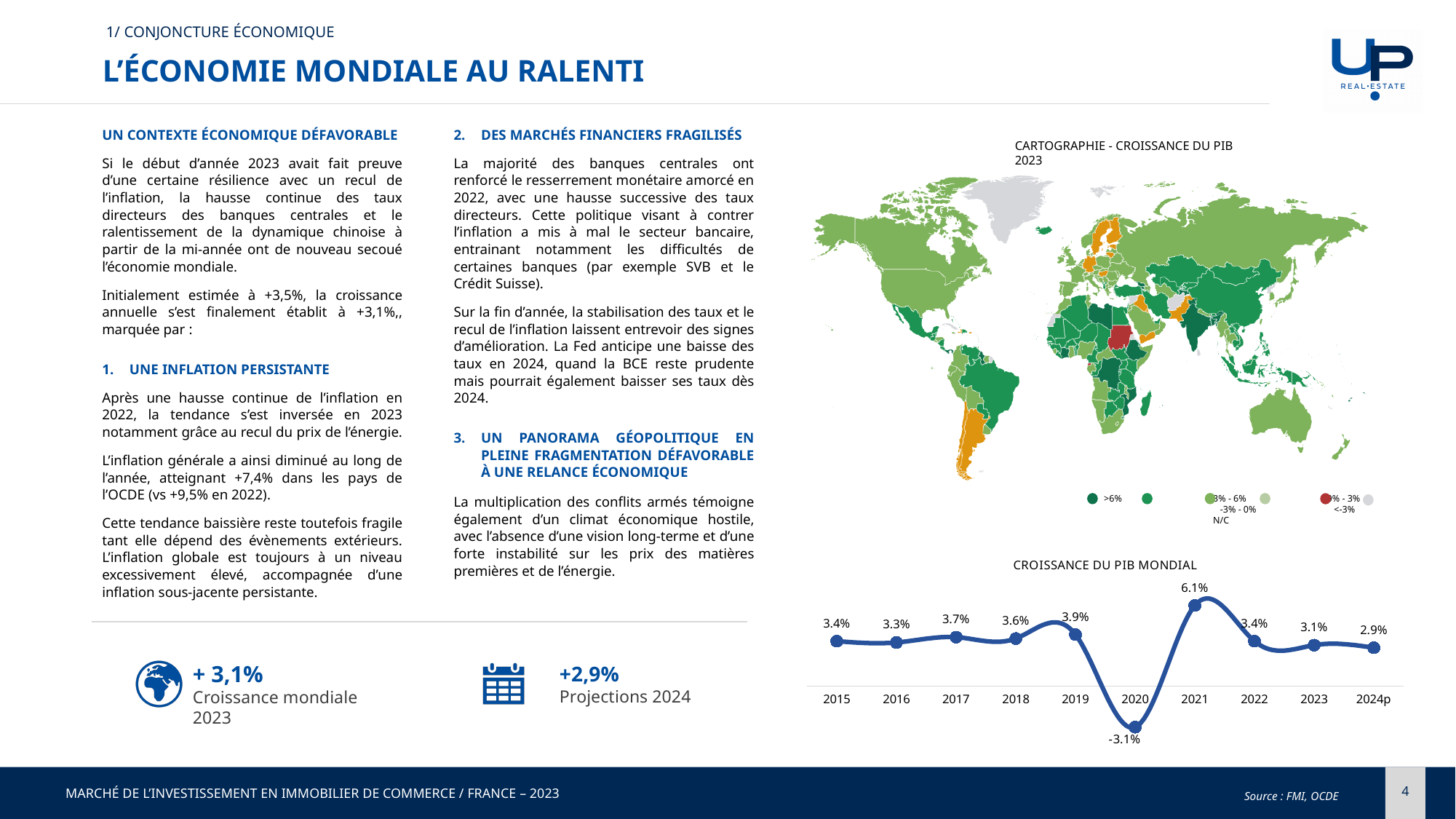
In the 'CROISSANCE DU PIB MONDIAL' chart, what is the value for 2024p? 2.9% How many years are plotted in the 'CROISSANCE DU PIB MONDIAL' chart? 10 In the 'CROISSANCE DU PIB MONDIAL' chart, which is larger, the value for 2017 or the value for 2016? 2017 In the 'CROISSANCE DU PIB MONDIAL' chart, what is the value for 2019? 3.9% In the 'CROISSANCE DU PIB MONDIAL' chart, which year has the lowest value? 2020 In the 'CROISSANCE DU PIB MONDIAL' chart, which year has the highest value? 2021 In the 'CROISSANCE DU PIB MONDIAL' chart, what is the value for 2021? 6.1% In the 'CROISSANCE DU PIB MONDIAL' chart, what is the value for 2020? -3.1% In the 'CROISSANCE DU PIB MONDIAL' chart, what is the difference between the 2023 value and the 2024p value? 0.2% What kind of chart is 'CROISSANCE DU PIB MONDIAL'? Line chart In the 'CROISSANCE DU PIB MONDIAL' chart, do the values rise or fall from 2021 to 2024p? Fall In the 'CROISSANCE DU PIB MONDIAL' chart, what is the difference between the 2021 value and the 2022 value? 2.7%